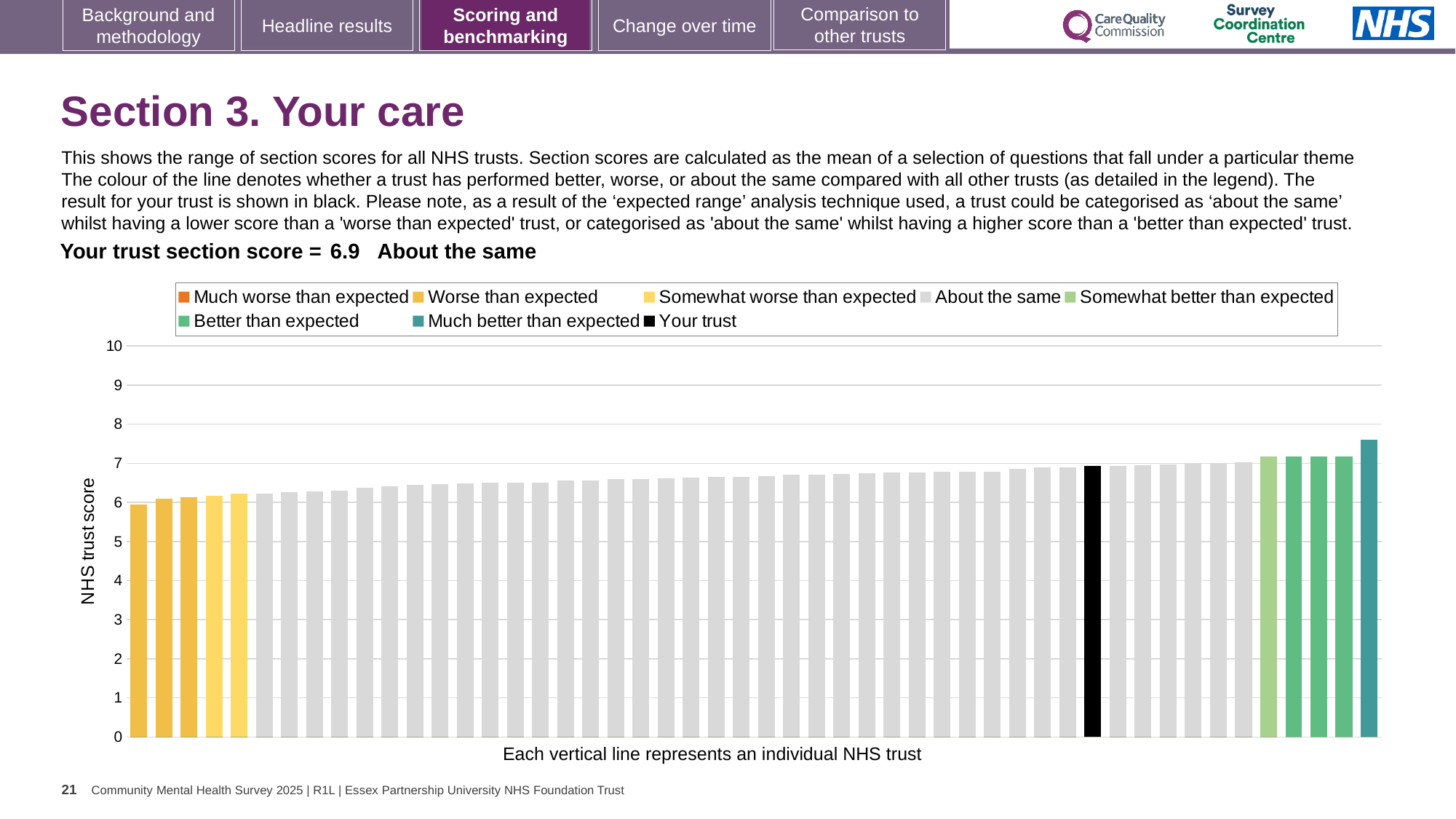
Which legend category does the tallest bar belong to? Much better than expected What is the label on the vertical axis of the chart? NHS trust score Is your trust's bar taller or shorter than the leftmost bar? taller Is the value for your trust's bar greater or less than 6? greater How many entries does the chart legend list? 8 What colour is the bar representing your trust? black Do the bar values rise or fall from left to right along the x axis? rise Is the value for the leftmost bar greater or less than 7? less Is the value for the rightmost (tallest) bar greater or less than 7? greater What kind of chart is shown on the slide? bar chart What is the section score for your trust shown on the slide? 6.9 Which performance category is your trust placed in for this section? About the same